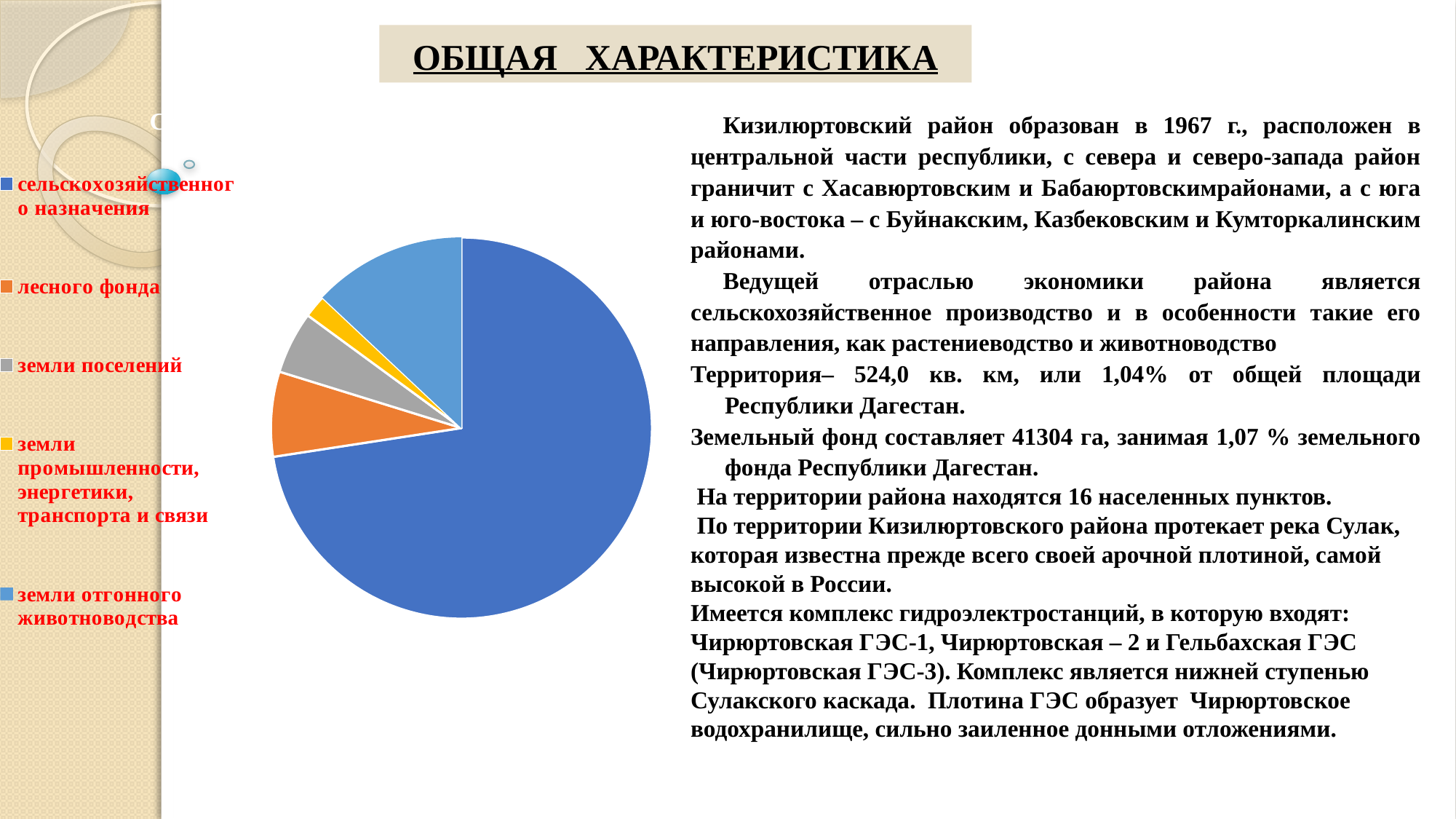
How many categories does the pie chart have? 5 Which slice is larger: 'лесного фонда' or 'земли отгонного животноводства'? земли отгонного животноводства Which slice is larger: 'сельскохозяйственного назначения' or 'лесного фонда'? сельскохозяйственного назначения How many entries does the legend of the pie chart list? 5 What colour is the slice for 'лесного фонда' in the pie chart? orange What colour is the slice for 'земли промышленности, энергетики, транспорта и связи'? yellow Which slice is larger: 'земли поселений' or 'земли промышленности, энергетики, транспорта и связи'? земли поселений What kind of chart is shown on the slide? pie chart Does the largest slice of the pie chart take up more or less than half of the pie? more Which category has the smallest slice of the pie chart? земли промышленности, энергетики, транспорта и связи Which category has the largest slice of the pie chart? сельскохозяйственного назначения